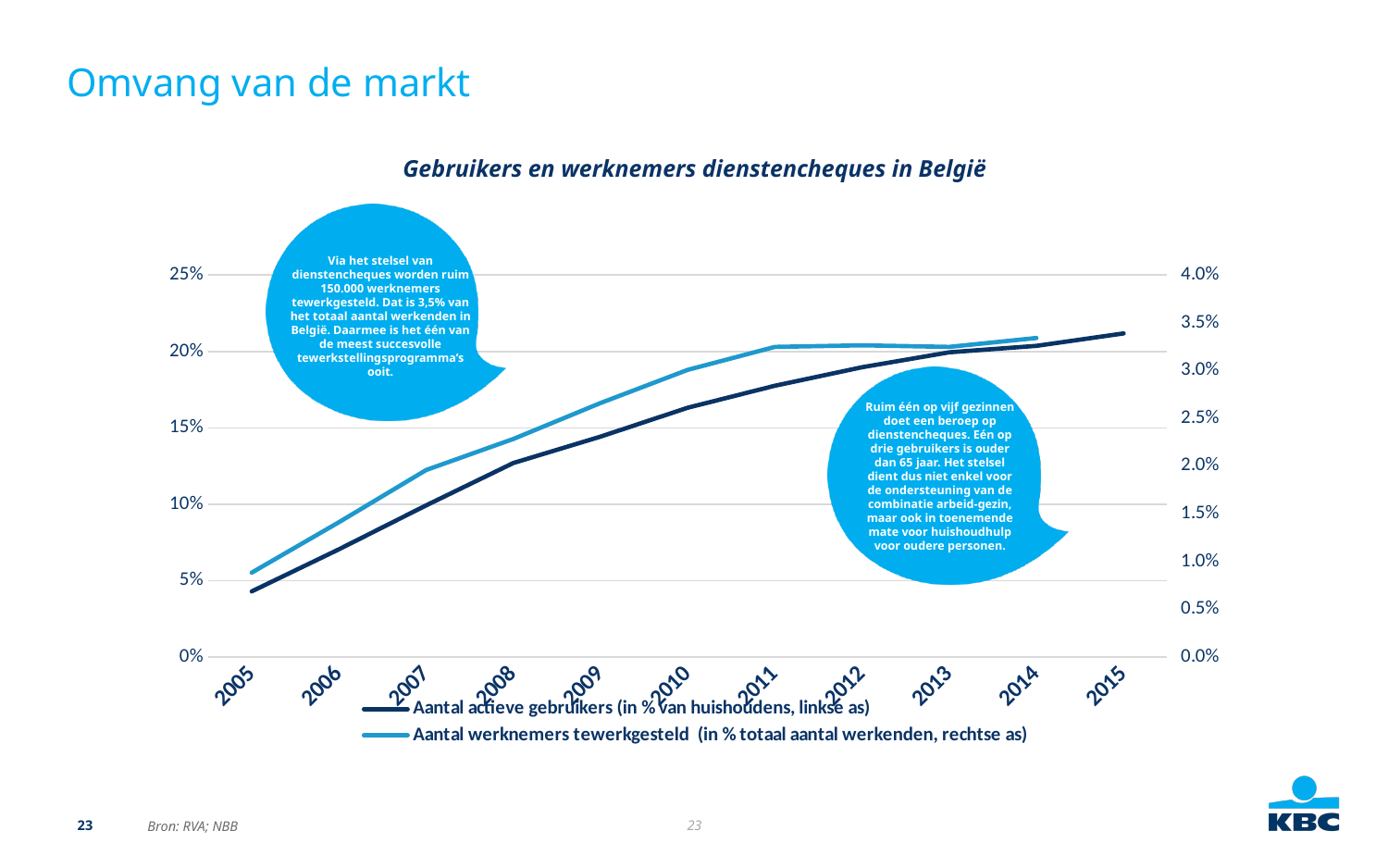
Is the value for 'Aantal actieve gebruikers' in 2015 greater or less than 20% on the left axis? greater In which year is the 'Aantal actieve gebruikers' series at its lowest? 2005 How many series does the legend list? 2 Is the value for 'Aantal actieve gebruikers' in 2008 greater or less than 10% on the left axis? greater What kind of chart is shown on the slide? Line chart How many years are shown on the x axis? 11 Is the value for 'Aantal werknemers tewerkgesteld' in 2011 greater or less than 3.0% on the right axis? greater What is the title of the chart? Gebruikers en werknemers dienstencheques in België Does the 'Aantal actieve gebruikers' series rise or fall from 2005 to 2015? Rise Which series is plotted against the right axis according to the legend? Aantal werknemers tewerkgesteld (in % totaal aantal werkenden, rechtse as) In which year is the 'Aantal actieve gebruikers' series at its highest? 2015